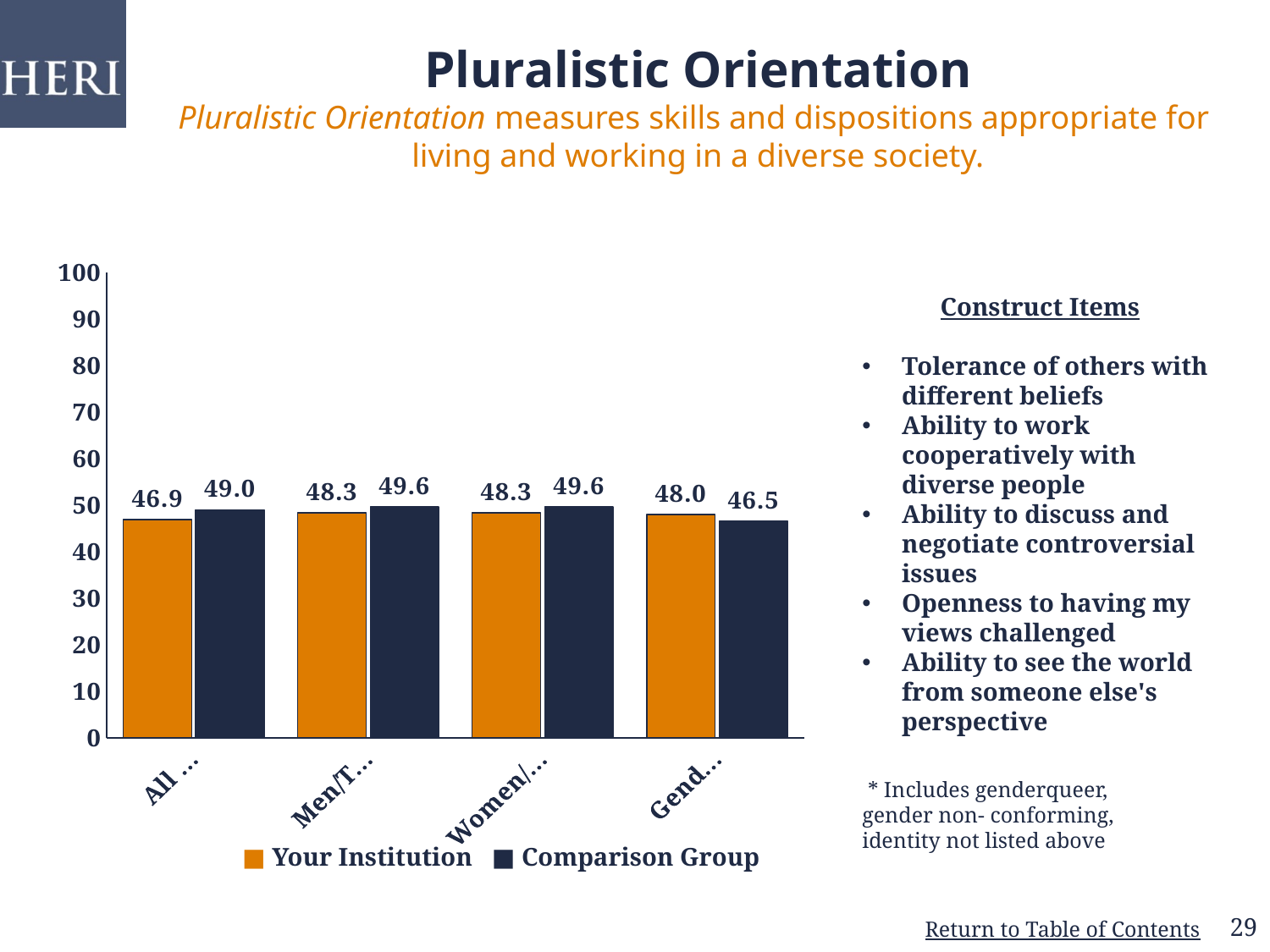
What is the Comparison Group value for the fourth category (labelled "Gend...")? 46.5 Is the Your Institution value for the third category ("Women/...") greater or less than 40? greater For which category is the Comparison Group value lowest? the fourth category ("Gend...") What is the Your Institution value for the first category (labelled "All ...")? 46.9 What kind of chart is shown on the slide? bar chart For the first category ("All ..."), what is the difference between the Comparison Group value and the Your Institution value? 2.1 How many series does the legend list? 2 What is the Comparison Group value for the second category (labelled "Men/T...")? 49.6 How many categories are shown on the x axis? 4 For which category is the Your Institution value lowest? the first category ("All ...") What are the two series named in the legend? Your Institution and Comparison Group For the fourth category ("Gend..."), which series has the larger value, Your Institution or Comparison Group? Your Institution